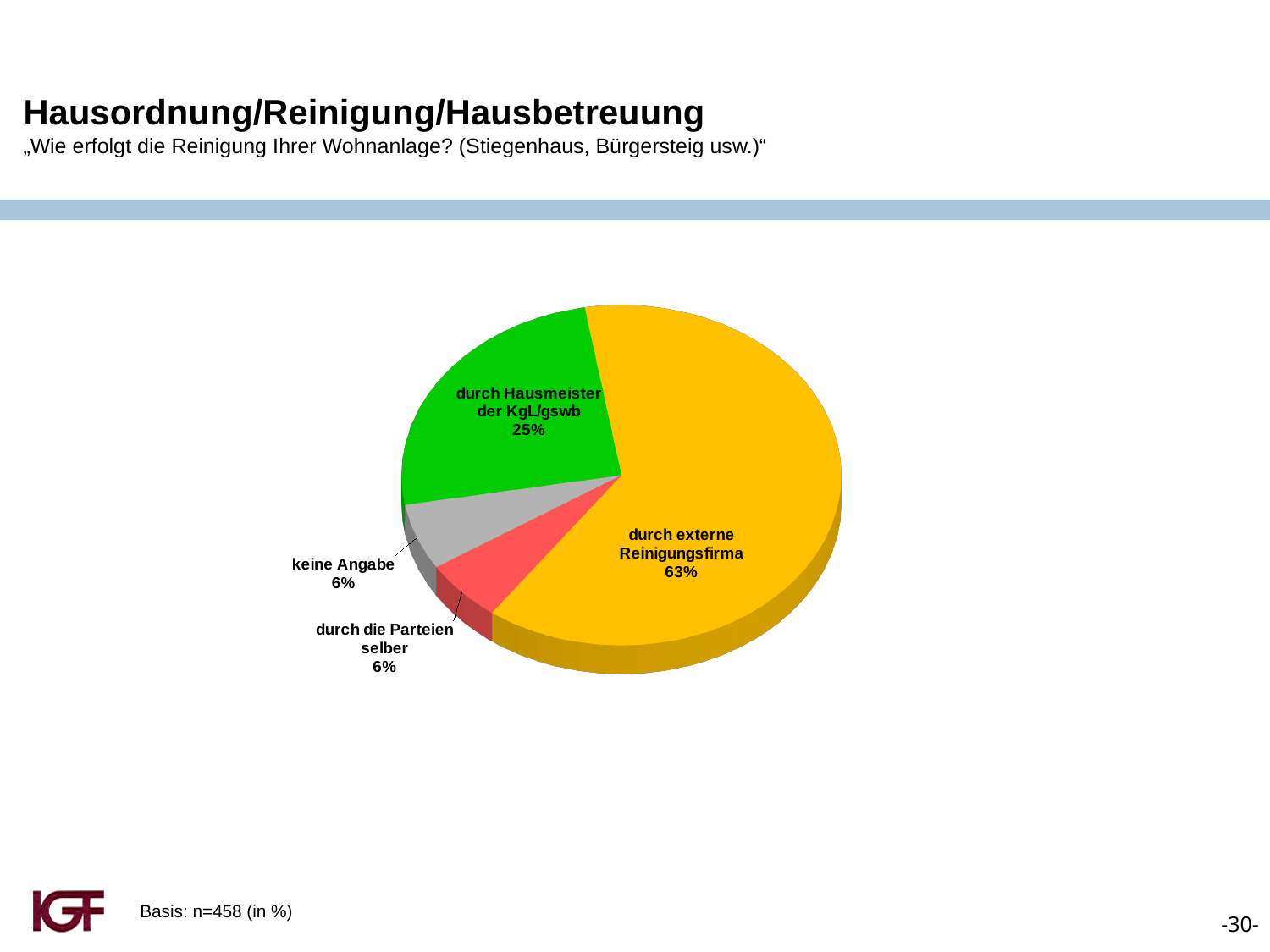
What share of the pie is 'durch Hausmeister der KgL/gswb'? 25% Which category has the largest share of the pie? durch externe Reinigungsfirma What colour is the slice for 'durch Hausmeister der KgL/gswb'? green Which is larger: 'durch Hausmeister der KgL/gswb' or 'keine Angabe'? durch Hausmeister der KgL/gswb What share of the pie is 'keine Angabe'? 6% What is the sample size (Basis) stated on the slide? n=458 What share of the pie is 'durch externe Reinigungsfirma'? 63% What is the difference in percentage points between 'durch externe Reinigungsfirma' and 'durch Hausmeister der KgL/gswb'? 38 What type of chart is shown on the slide? pie chart How many slices does the pie chart have? 4 What share of the pie is 'durch die Parteien selber'? 6% What is the combined share of 'keine Angabe' and 'durch die Parteien selber'? 12%